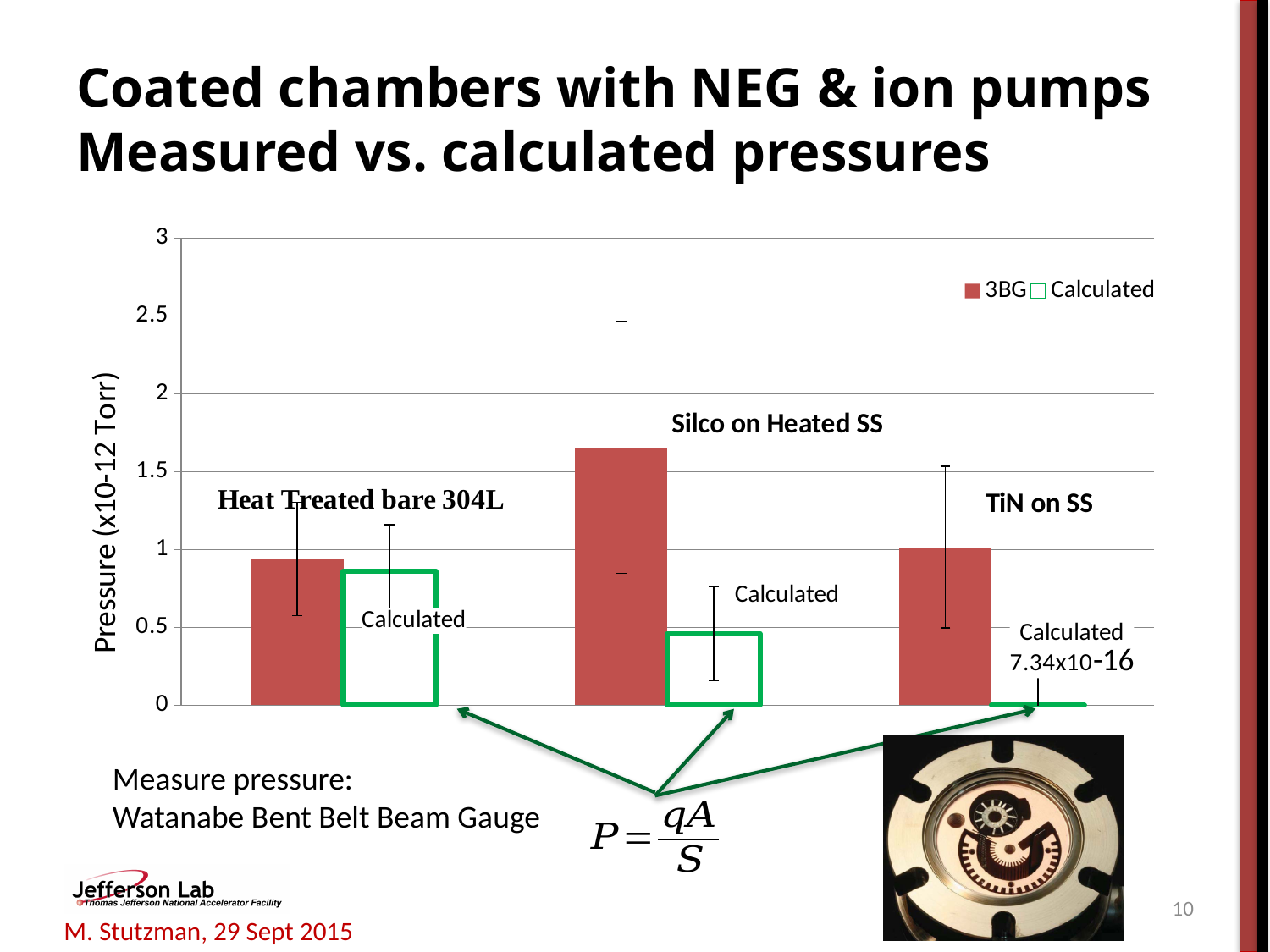
What is the calculated pressure value printed for TiN on SS? 7.34x10-16 How many series does the chart legend list? 2 Which has the larger measured (3BG) value: Silco on Heated SS or TiN on SS? Silco on Heated SS Is the measured (3BG) value for Silco on Heated SS greater or less than 1.5? greater Is the calculated value for Silco on Heated SS greater or less than 1? less Is the measured (3BG) value for TiN on SS greater or less than 1.5? less Which is larger for Silco on Heated SS: the 3BG measured value or the Calculated value? 3BG Which category has the highest measured (3BG) pressure? Silco on Heated SS What kind of chart is shown on the slide? bar chart What is the label of the vertical axis? Pressure (x10-12 Torr) How many categories (chamber types) are shown in the chart? 3 Which category has the lowest calculated pressure? TiN on SS